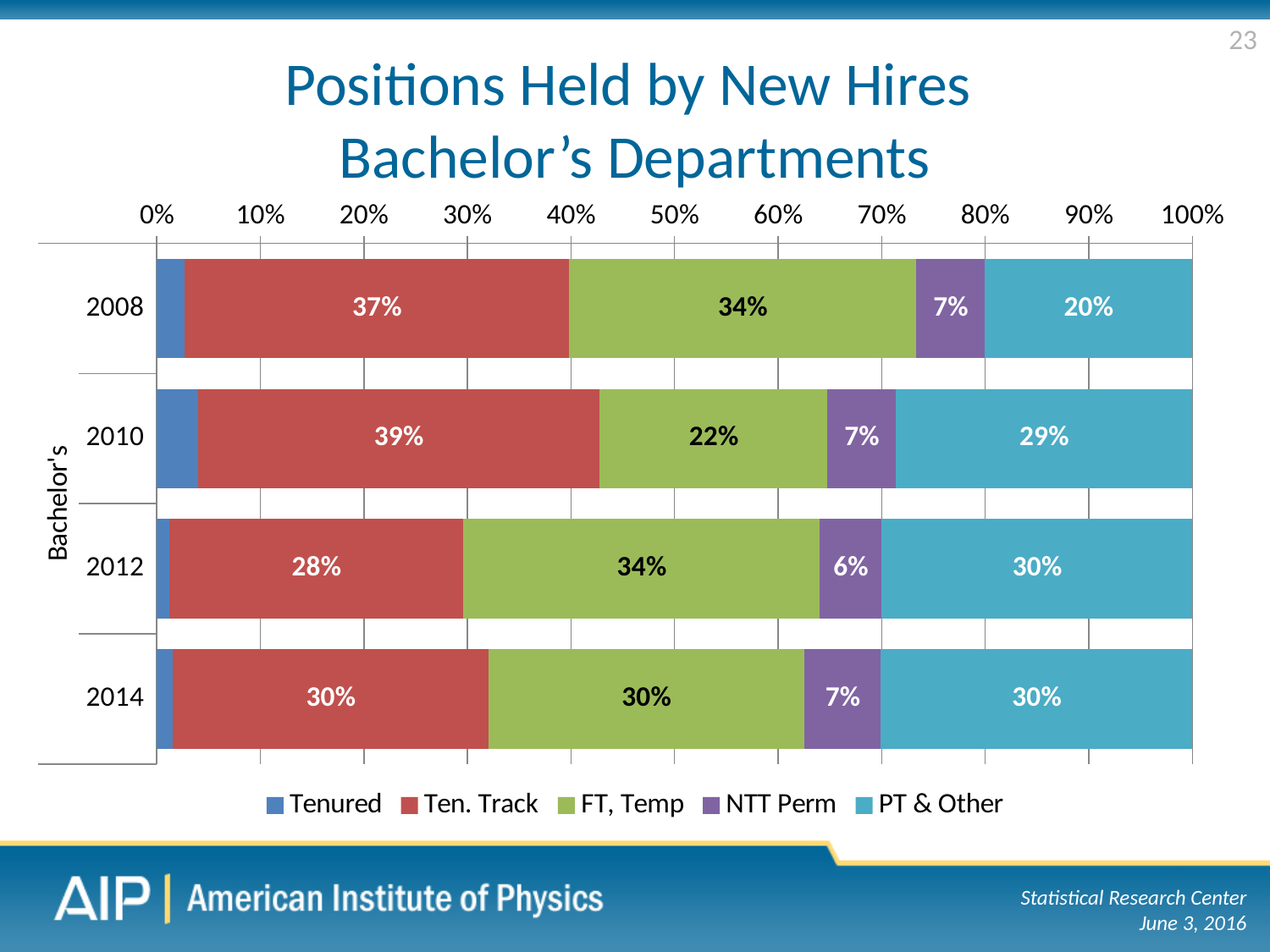
How many series does the legend list? 5 In which year was the FT, Temp share lowest? 2010 What is the NTT Perm value for 2012? 6% What is the FT, Temp share for 2012? 34% In which year was the Ten. Track share highest? 2010 How many percentage points higher is the PT & Other share in 2010 than in 2008? 9 percentage points What kind of chart is shown on the slide? Stacked bar chart How many years are shown on the chart? 4 Is the Tenured value for 2010 greater or less than 10%? less What is the PT & Other value for 2008? 20% Which is larger, the Ten. Track share in 2008 or in 2012? 2008 What percentage of new hires in 2010 held Ten. Track positions? 39%